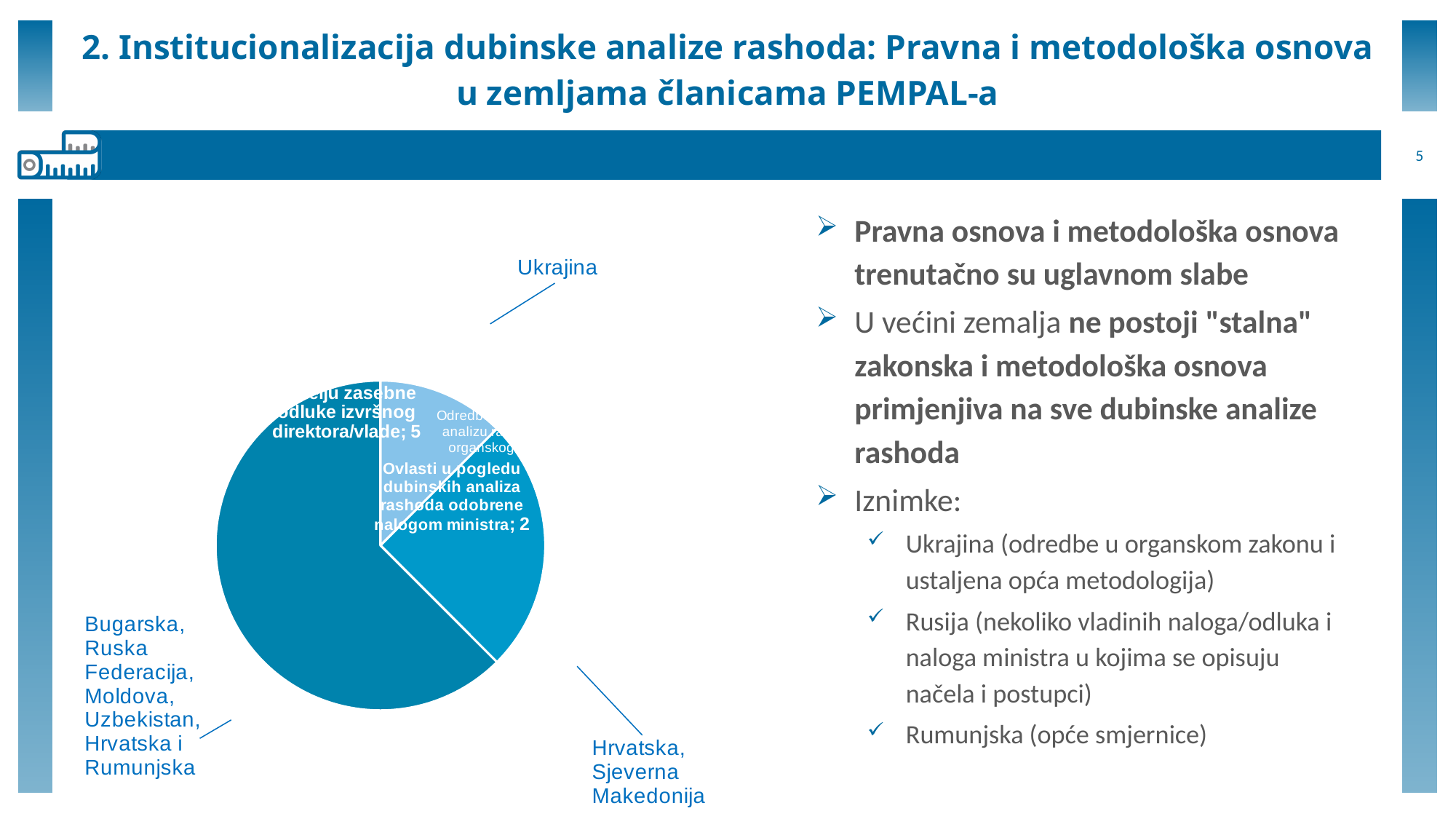
Which country is annotated next to the smallest slice of the pie chart? Ukrajina Which is larger: the Ukrajina slice or the slice for 'odobrene nalogom ministra'? odobrene nalogom ministra Which slice of the pie chart is the smallest? the Ukrajina slice What kind of chart is shown on the slide? pie chart Which slice of the pie chart is the largest? odluke izvršnog direktora/vlade (5) Which is larger: the slice for 'odluke izvršnog direktora/vlade' or the slice for 'odobrene nalogom ministra'? odluke izvršnog direktora/vlade How many slices does the pie chart have? 3 What value is shown for the slice labelled '...odluke izvršnog direktora/vlade'? 5 What value is shown for the slice 'Ovlasti u pogledu dubinskih analiza rashoda odobrene nalogom ministra'? 2 What is the difference between the slice valued 5 and the slice valued 2? 3 Which countries are annotated next to the slice 'odobrene nalogom ministra; 2'? Hrvatska, Sjeverna Makedonija